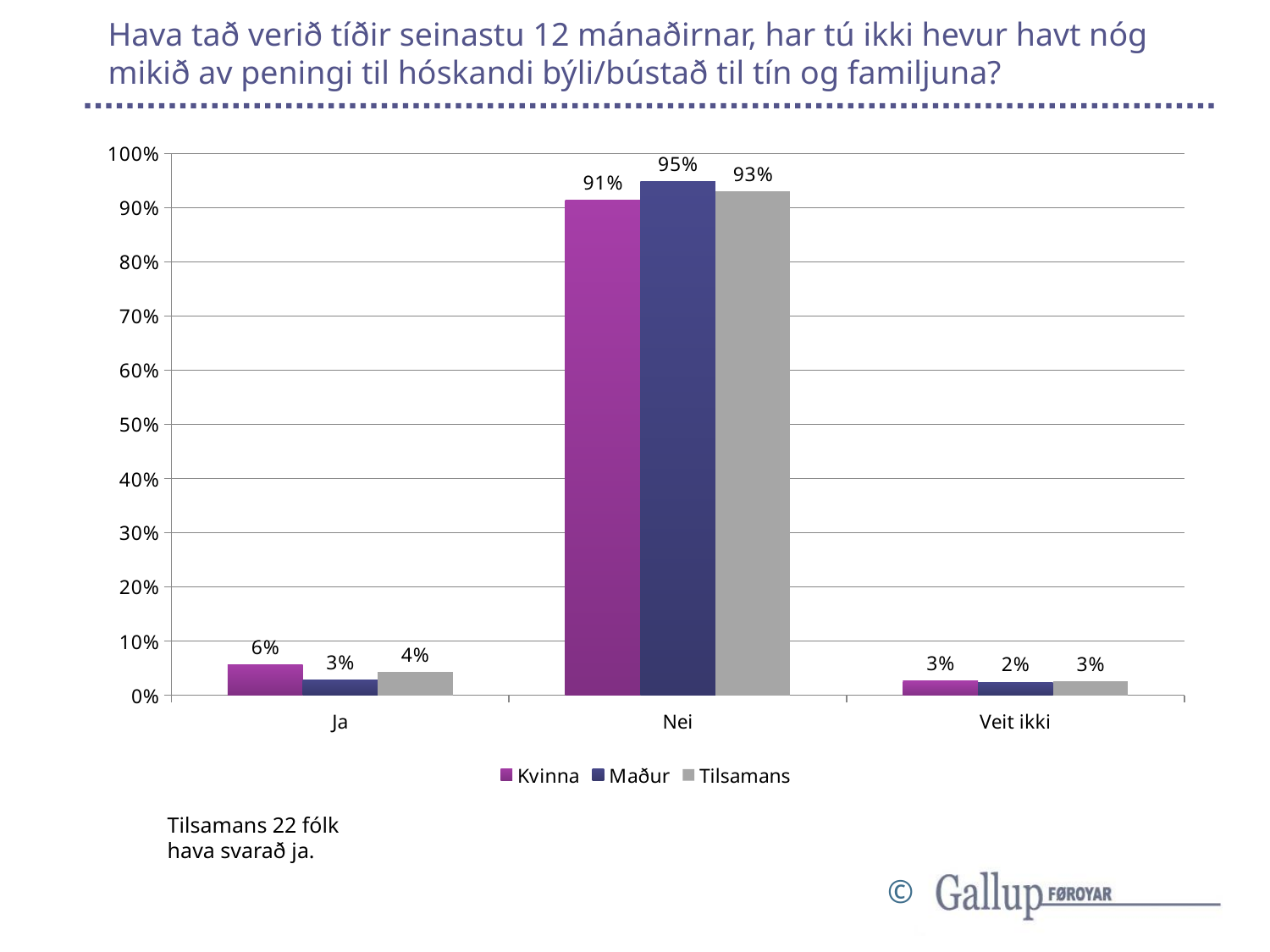
How many series does the legend list? 3 What is the value for Tilsamans in the Veit ikki category? 3% What is the value for Kvinna in the Ja category? 6% Is the value for Kvinna in the Nei category greater or less than 80%? greater Which series has the lowest value in the Ja category? Maður Which is larger in the Ja category, the value for Kvinna or the value for Maður? Kvinna What is the difference between the Maður and Kvinna values in the Nei category? 4% What is the value for Maður in the Nei category? 95% What colour are the Kvinna bars? purple How many categories are shown on the x axis? 3 Which category has the highest value for Tilsamans? Nei What kind of chart is shown on the slide? bar chart